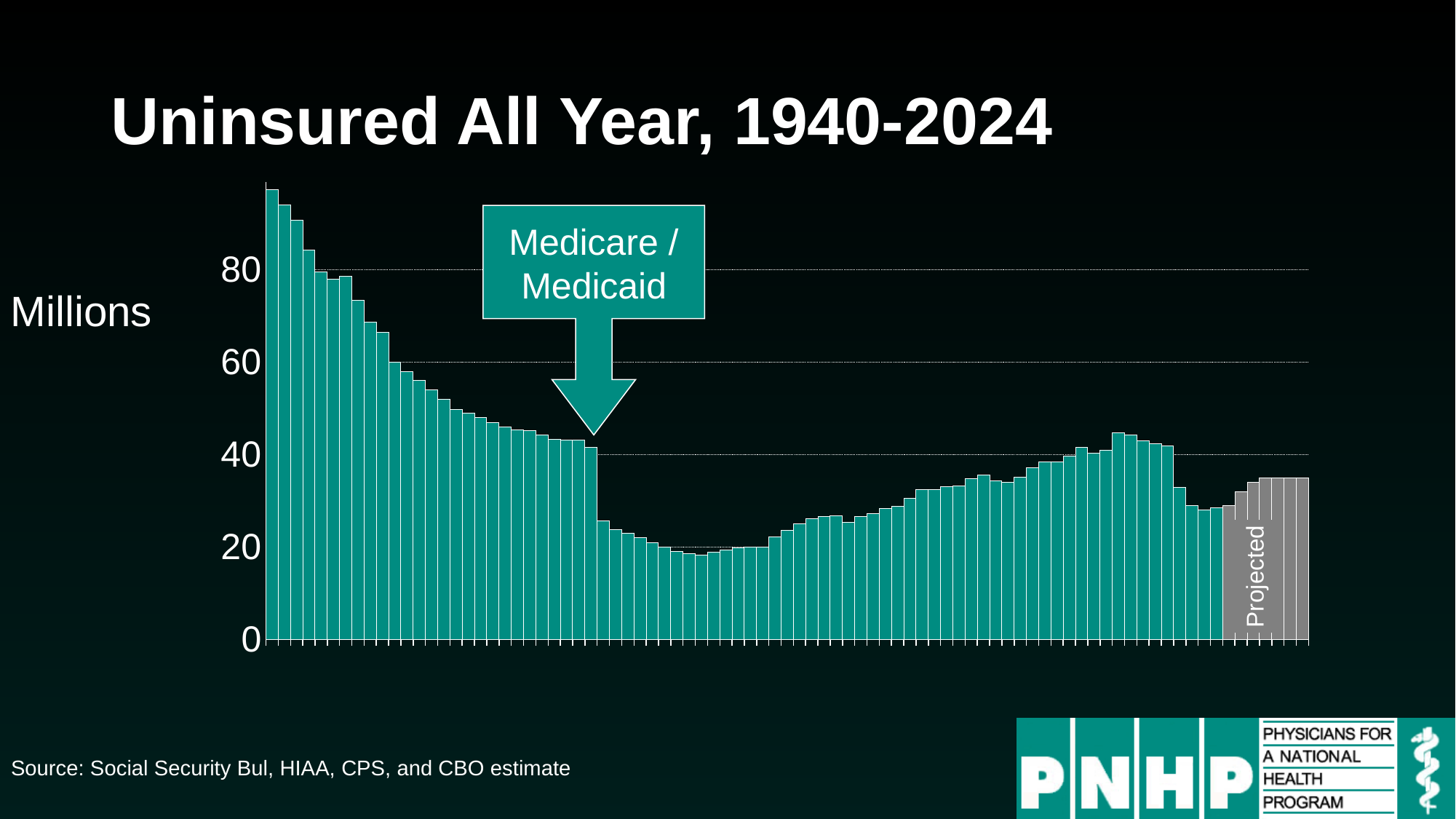
Is the value of the rightmost (projected) bar greater or less than 20? greater What is the title of the chart? Uninsured All Year, 1940-2024 From the leftmost bar up to the Medicare / Medicaid arrow, do the values rise or fall? fall Is the value of the first bar immediately after the Medicare / Medicaid arrow greater or less than 40? less Which is larger, the leftmost bar or the rightmost bar? the leftmost bar What kind of chart is shown on the slide? bar chart What event does the arrow annotation on the chart mark? Medicare / Medicaid Is the value of the leftmost bar greater or less than 80? greater Which bar has the highest value in the chart? the leftmost bar